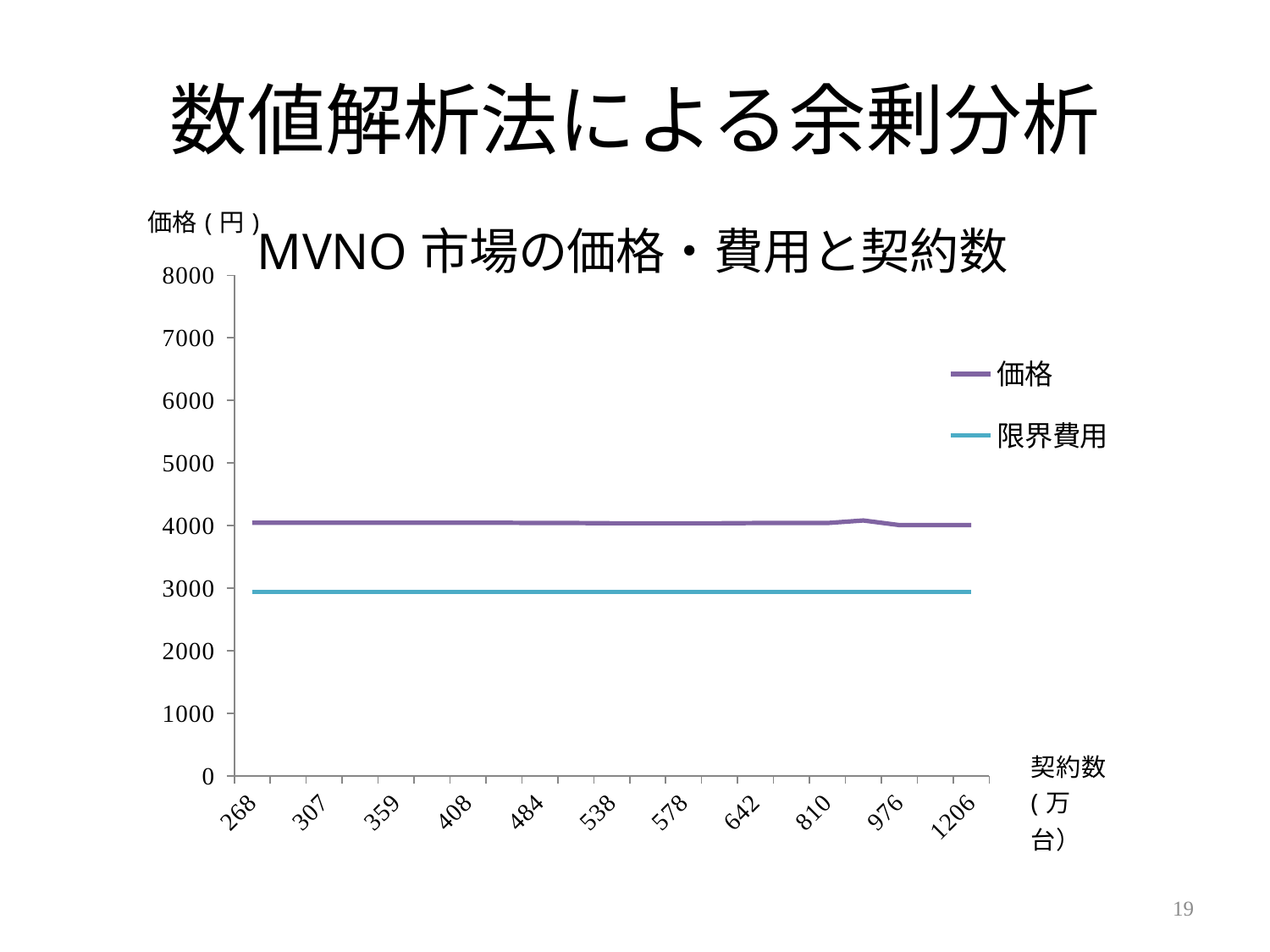
At 契約数 1206, which series has the lower value, 価格 or 限界費用? 限界費用 How many categories are shown on the x axis? 11 What is the title of the chart? MVNO 市場の価格・費用と契約数 What is the first category label on the x axis? 268 Is the value of 価格 at 1206 greater or less than 5000? less Which series is drawn in purple? 価格 Is the value of 限界費用 at 538 greater or less than 2000? greater At 契約数 268, which series has the higher value, 価格 or 限界費用? 価格 What kind of chart is shown on the slide? line chart Is the value of 価格 at 268 greater or less than 3000? greater How many series does the legend list? 2